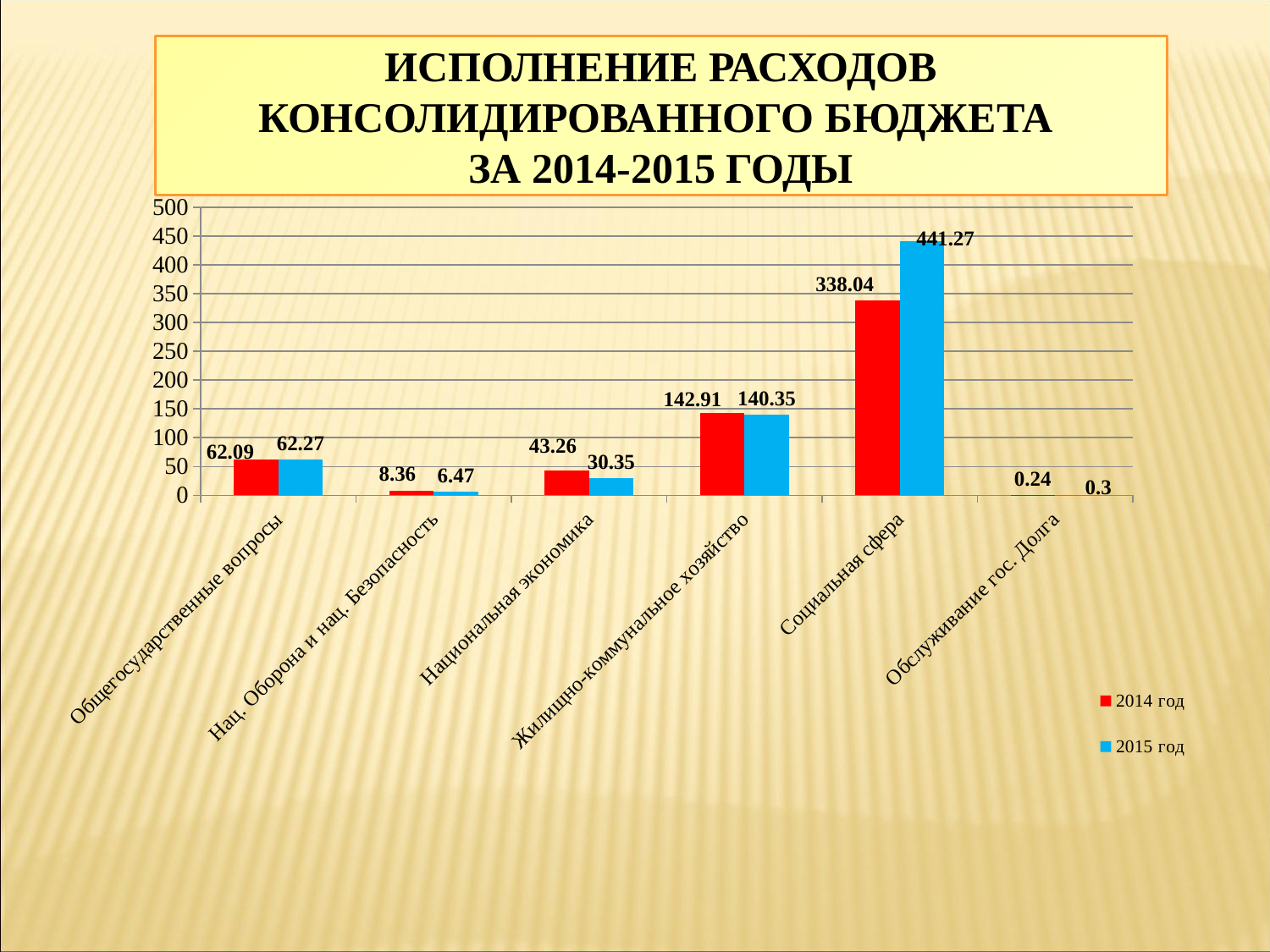
What kind of chart is shown on the slide? Bar chart What is the 2014 год value for Социальная сфера? 338.04 What is the difference between the 2014 год and 2015 год values for Национальная экономика? 12.91 How many categories are shown on the x axis? 6 For Нац. Оборона и нац. Безопасность, which year has the larger value, 2014 год or 2015 год? 2014 год What is the 2015 год value for Обслуживание гос. Долга? 0.3 Which category has the highest 2015 год value? Социальная сфера How many series does the legend list? 2 What is the 2015 год value for Национальная экономика? 30.35 Which category has the lowest 2014 год value? Обслуживание гос. Долга What is the difference between the 2015 год and 2014 год values for Социальная сфера? 103.23 What is the 2014 год value for Жилищно-коммунальное хозяйство? 142.91